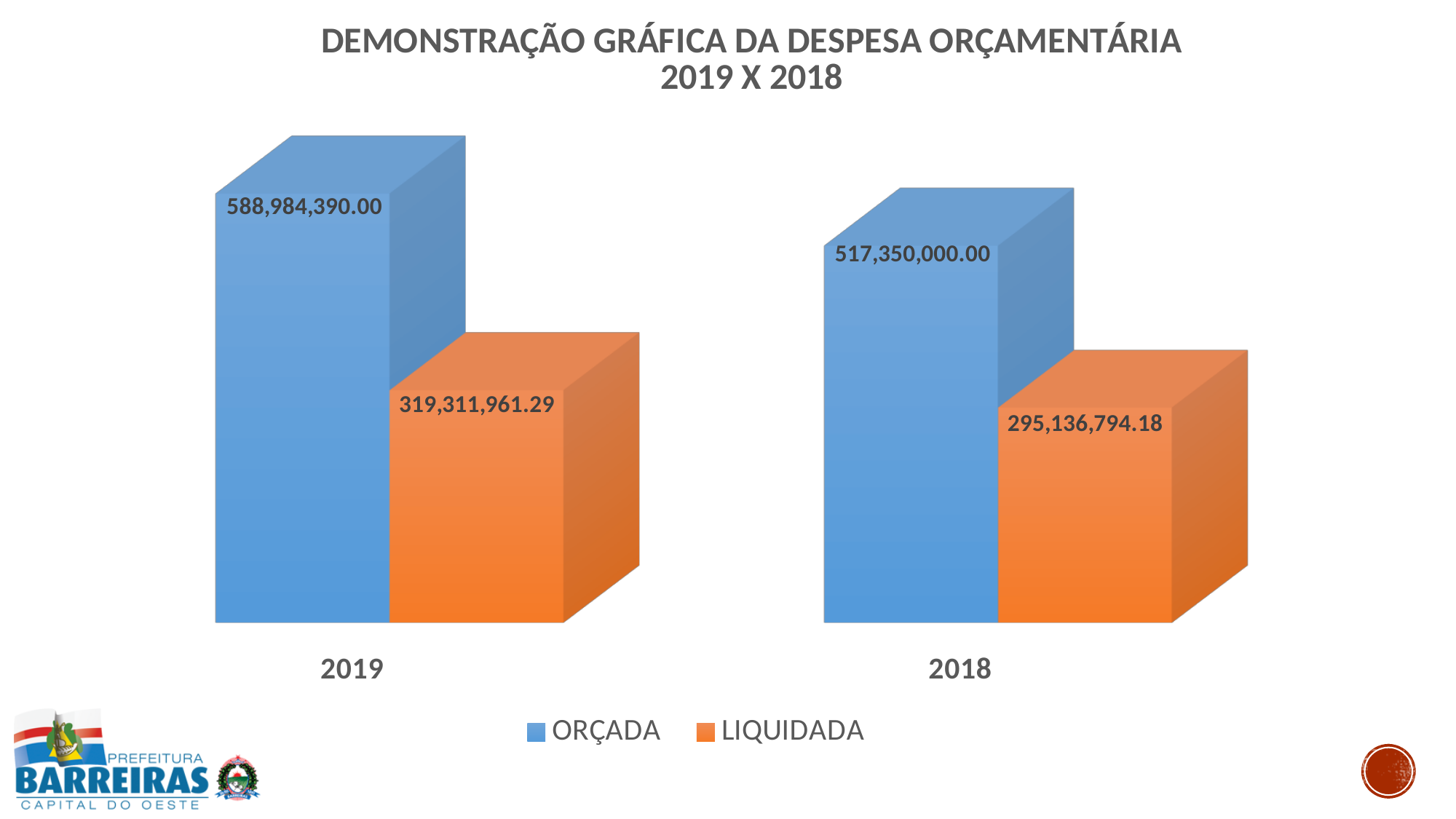
How many series does the legend list? 2 What is the difference between the ORÇADA and LIQUIDADA values for 2019? 269,672,428.71 What is the ORÇADA value for 2019? 588,984,390.00 How many years (categories) are shown on the chart? 2 Which year has the higher ORÇADA value? 2019 What kind of chart is shown on the slide? bar chart What is the LIQUIDADA value for 2019? 319,311,961.29 What is the ORÇADA value for 2018? 517,350,000.00 What is the difference between the ORÇADA values for 2019 and 2018? 71,634,390.00 What is the LIQUIDADA value for 2018? 295,136,794.18 Which bar has the lowest value on the chart? LIQUIDADA for 2018 Is the LIQUIDADA value for 2019 larger or smaller than the LIQUIDADA value for 2018? larger